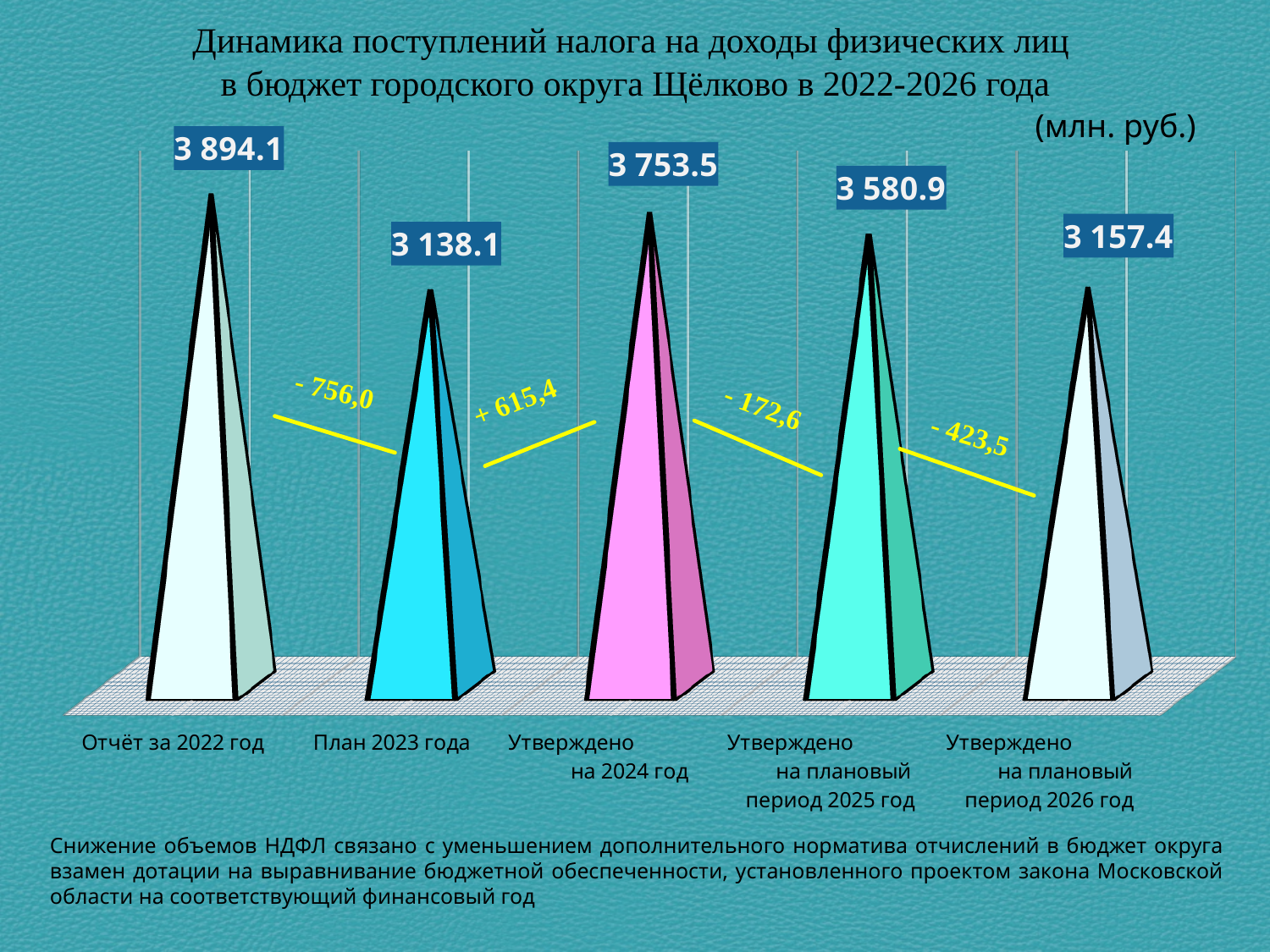
How many categories are shown on the chart? 5 Which is larger: the value for «Утверждено на 2024 год» or the value for «Утверждено на плановый период 2025 год»? Утверждено на 2024 год What is the value for «Утверждено на плановый период 2026 год»? 3 157.4 What kind of chart is shown on the slide? Bar chart Which category has the lowest value? План 2023 года What is the value for «План 2023 года»? 3 138.1 Which category has the highest value? Отчёт за 2022 год What is the value for «Утверждено на 2024 год»? 3 753.5 What is the difference between the values for «Отчёт за 2022 год» and «План 2023 года»? 756.0 In what units are the values on the chart given? млн. руб. What is the difference between the values for «Утверждено на плановый период 2025 год» and «Утверждено на плановый период 2026 год»? 423.5 What is the value for «Отчёт за 2022 год»? 3 894.1